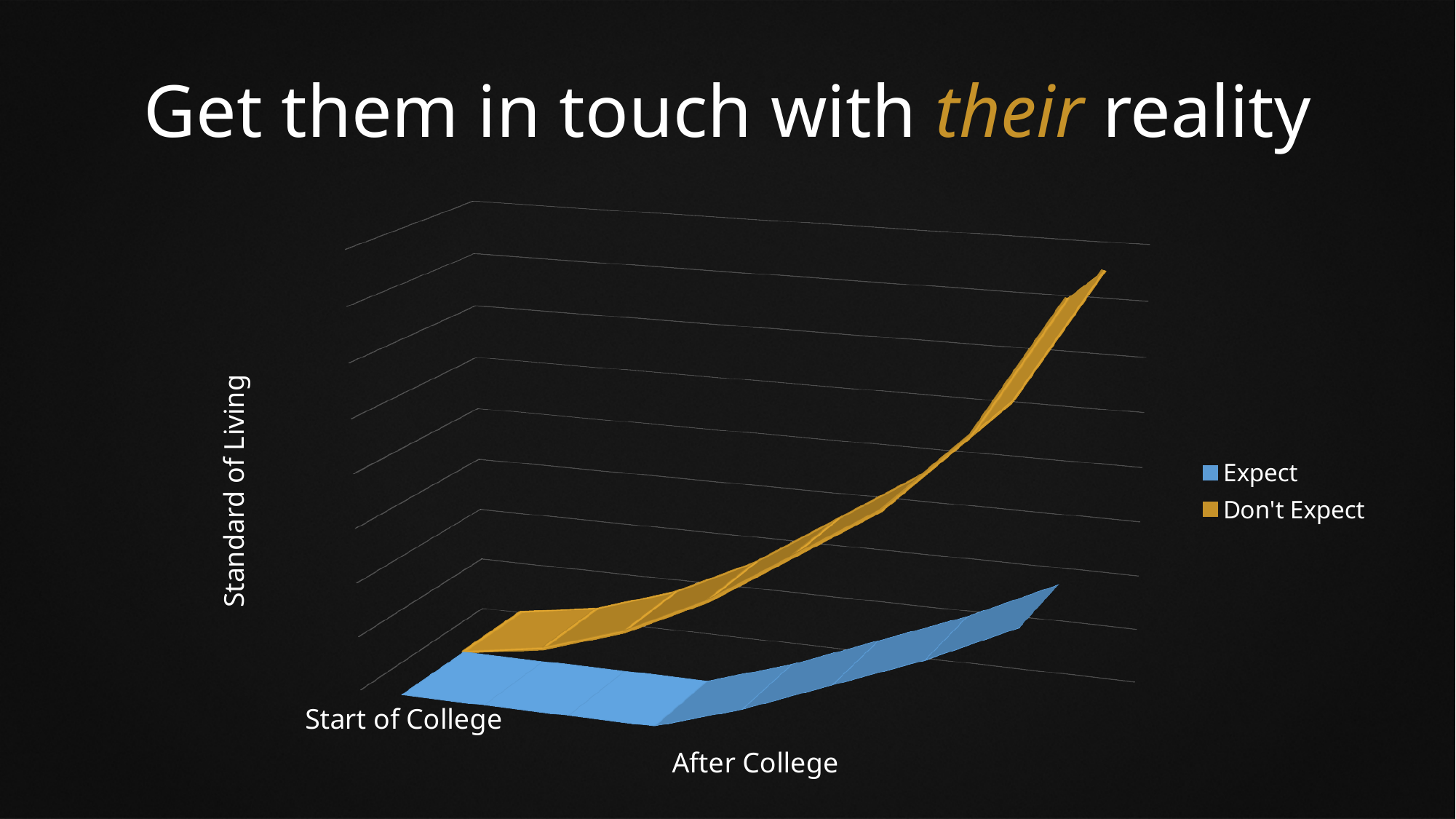
Which series shows the steeper increase toward the right end of the chart? Don't Expect What are the two category labels readable on the x axis? Start of College and After College Which series reaches the higher Standard of Living at the right end of the chart, Expect or Don't Expect? Don't Expect What are the names of the series in the chart legend? Expect and Don't Expect What is the title of the vertical axis of the chart? Standard of Living Does the Don't Expect series rise or fall along the x axis? Rise What kind of chart is shown on the slide? Line chart Which series is drawn in blue? Expect How many series does the chart legend list? 2 Does the Expect series rise or fall overall from Start of College to the right end of the chart? Rise